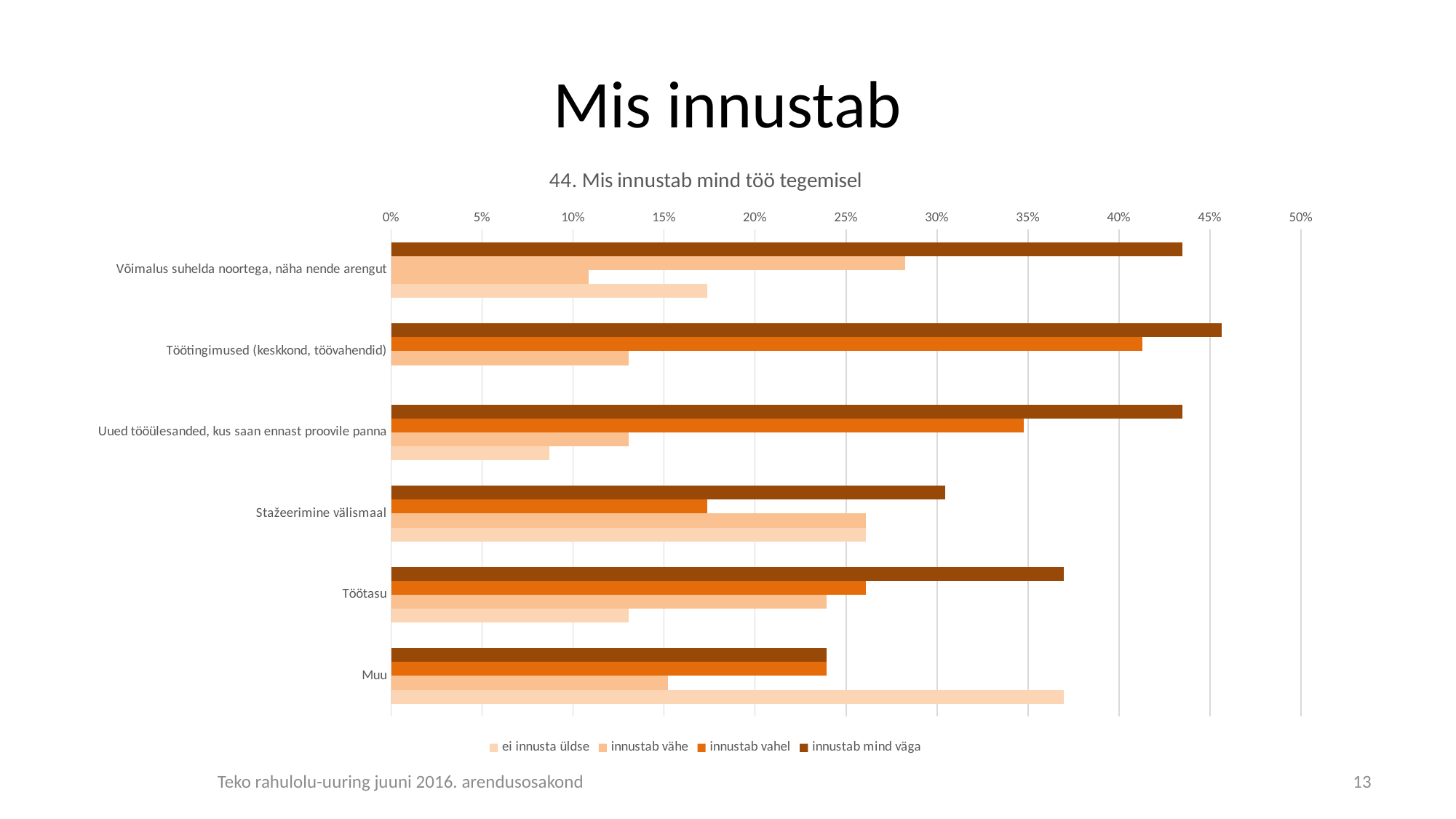
How many categories are plotted on the chart? 6 What is the title of the chart? 44. Mis innustab mind töö tegemisel Which category has the highest value for the series 'ei innusta üldse'? Muu For the series 'innustab mind väga', which category has the larger value: 'Töötasu' or 'Stažeerimine välismaal'? Töötasu How many series does the legend list? 4 Is the value for 'innustab vähe' in the category 'Võimalus suhelda noortega, näha nende arengut' greater or less than 15%? less Is the value for 'ei innusta üldse' in the category 'Muu' greater or less than 35%? greater Is the value for 'innustab vahel' in the category 'Uued tööülesanded, kus saan ennast proovile panna' greater or less than 30%? greater Which category has the lowest value for the series 'innustab mind väga'? Muu What kind of chart is shown on the slide? bar chart In the category 'Muu', which series has the larger value: 'ei innusta üldse' or 'innustab vähe'? ei innusta üldse